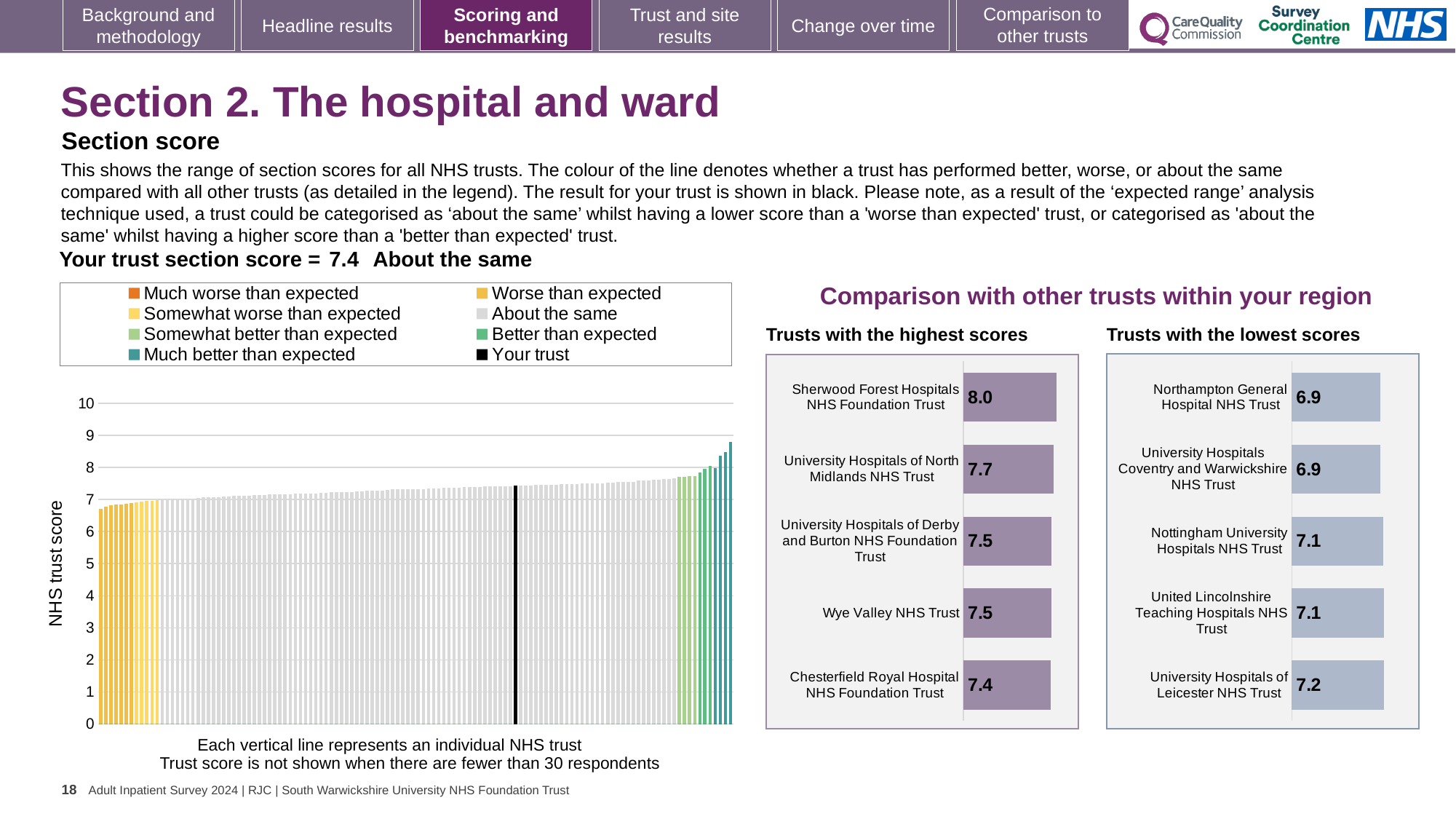
In the 'Trusts with the highest scores' chart, what is the difference between the scores of Sherwood Forest Hospitals NHS Foundation Trust and Chesterfield Royal Hospital NHS Foundation Trust? 0.6 In the 'Trusts with the lowest scores' chart, what is the score for Northampton General Hospital NHS Trust? 6.9 What kind of chart is the large chart on the left showing NHS trust scores? bar chart How many trusts are shown in the 'Trusts with the highest scores' chart? 5 In the 'Trusts with the highest scores' chart, which trust has the highest score? Sherwood Forest Hospitals NHS Foundation Trust In the 'Trusts with the lowest scores' chart, which trust has the highest score? University Hospitals of Leicester NHS Trust In the 'Trusts with the lowest scores' chart, what is the score for University Hospitals of Leicester NHS Trust? 7.2 In the 'Trusts with the lowest scores' chart, which has the larger score: Nottingham University Hospitals NHS Trust or Northampton General Hospital NHS Trust? Nottingham University Hospitals NHS Trust In the 'Trusts with the highest scores' chart, what is the score for Sherwood Forest Hospitals NHS Foundation Trust? 8.0 In the large chart on the left, do the trust scores rise or fall from left to right? rise How many entries does the legend of the large chart on the left list? 8 In the 'Trusts with the highest scores' chart, what is the score for Chesterfield Royal Hospital NHS Foundation Trust? 7.4